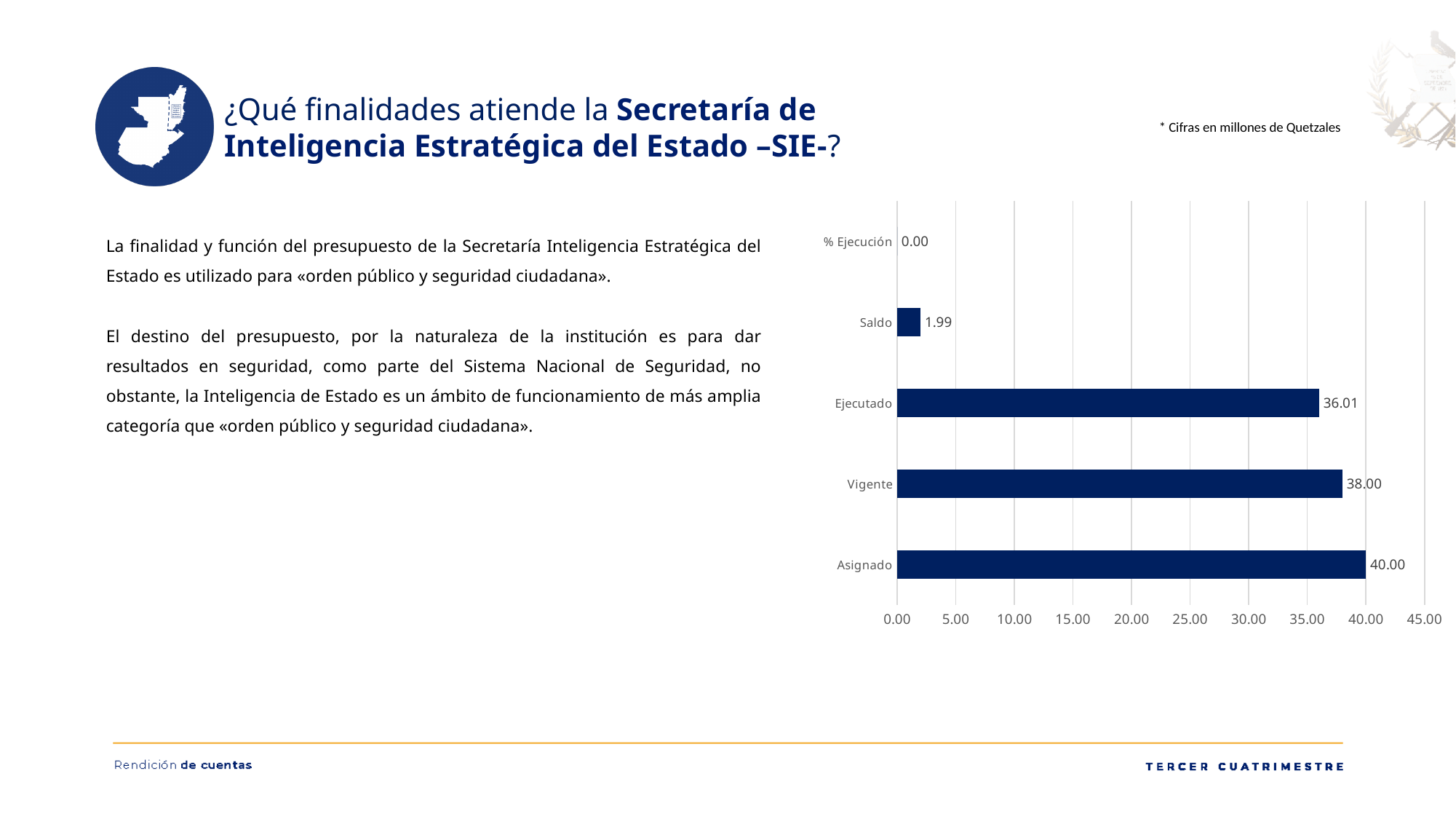
What is the value shown for % Ejecución? 0.00 What is the value for Ejecutado? 36.01 Which is larger, the value for Asignado or the value for Vigente? Asignado What is the difference between the Vigente and Ejecutado values? 1.99 What is the value for Asignado? 40.00 Which category has the lowest value? % Ejecución Which category has the highest value? Asignado How many categories are shown on the chart? 5 What kind of chart is shown on the slide? Bar chart What is the highest value shown on the x axis? 45.00 What is the value for Vigente? 38.00 What is the value for Saldo? 1.99